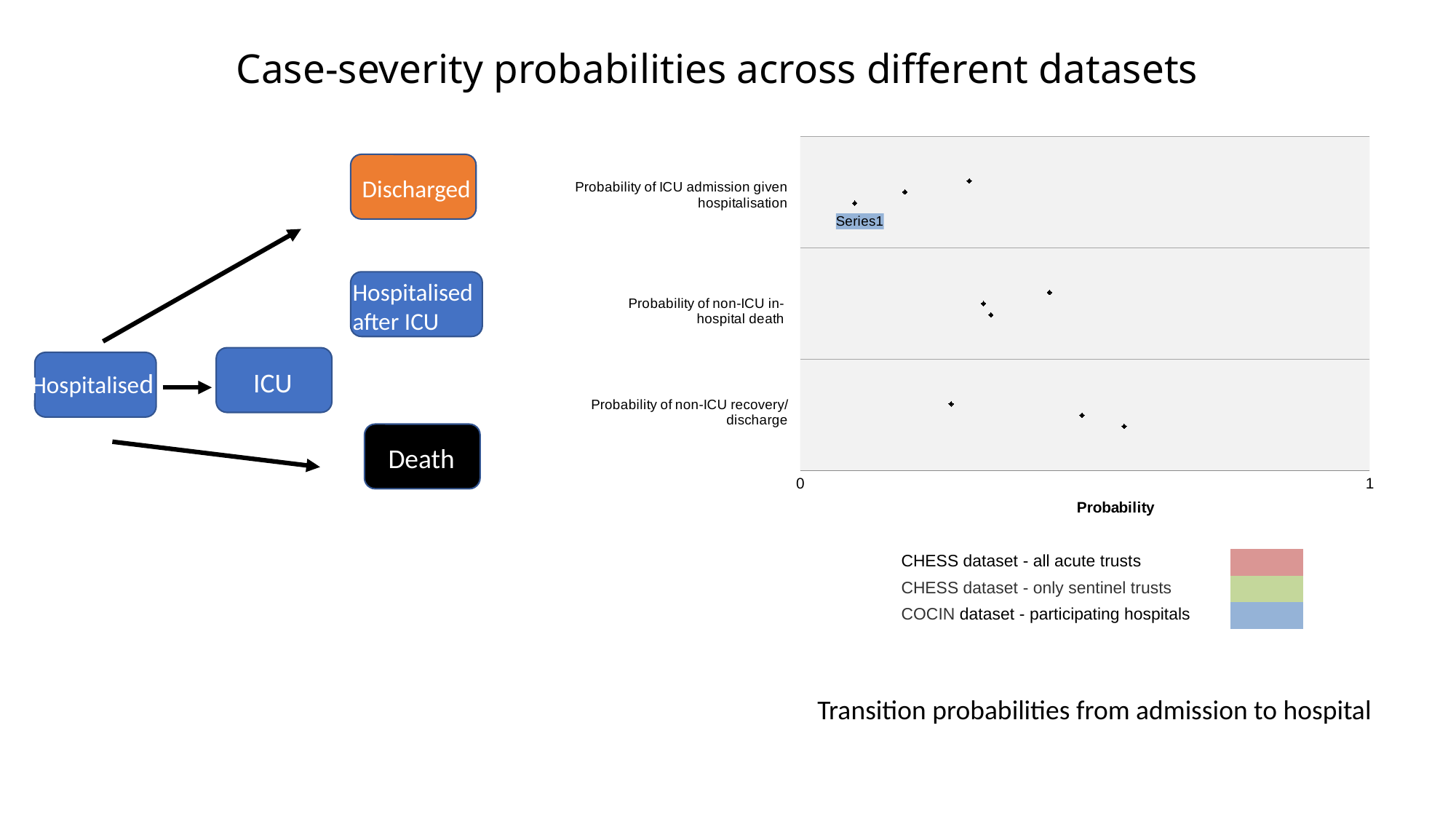
Are the plotted values for 'Probability of ICU admission given hospitalisation' higher or lower than those for 'Probability of non-ICU in-hospital death'? lower Which category has the lowest plotted probabilities? Probability of ICU admission given hospitalisation How many data points are plotted in total on the chart? 9 How many categories are listed on the vertical axis of the chart? 3 How many data points are plotted for the category 'Probability of ICU admission given hospitalisation'? 3 What kind of chart is shown on the right of the slide? Scatter (dot) plot What are the minimum and maximum tick values shown on the horizontal axis? 0 and 1 Which category contains the single highest plotted point? Probability of non-ICU recovery/discharge What is the title of the horizontal axis of the chart? Probability How many datasets does the legend below the chart list? 3